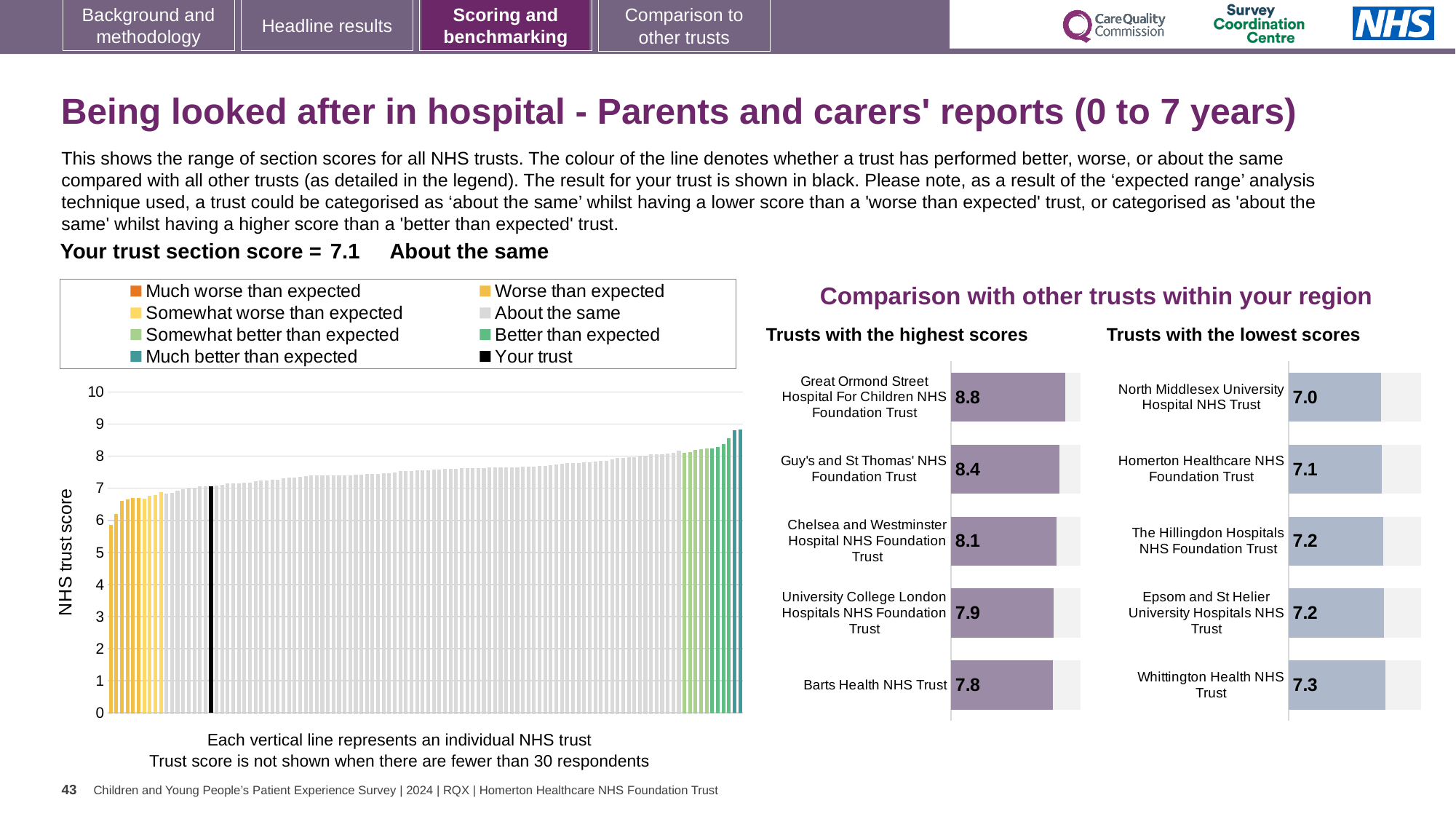
In the 'Trusts with the lowest scores' chart, what is the score for North Middlesex University Hospital NHS Trust? 7.0 In the 'Trusts with the lowest scores' chart, what is the score for Whittington Health NHS Trust? 7.3 In the 'Trusts with the highest scores' chart, what is the score for Great Ormond Street Hospital For Children NHS Foundation Trust? 8.8 In the 'Trusts with the highest scores' chart, what is the score for Barts Health NHS Trust? 7.8 What kind of chart is the main 'NHS trust score' chart on the left? Bar chart In the main 'NHS trust score' chart on the left, what is the section score for your trust? 7.1 How many entries does the legend of the main 'NHS trust score' chart list? 8 In the 'Trusts with the highest scores' chart, what is the difference between the scores of Great Ormond Street Hospital For Children NHS Foundation Trust and Guy's and St Thomas' NHS Foundation Trust? 0.4 In the 'Trusts with the lowest scores' chart, which has the higher score: Homerton Healthcare NHS Foundation Trust or Whittington Health NHS Trust? Whittington Health NHS Trust In the 'Trusts with the lowest scores' chart, which trust has the lowest score? North Middlesex University Hospital NHS Trust In the 'Trusts with the highest scores' chart, which trust has the highest score? Great Ormond Street Hospital For Children NHS Foundation Trust How many trusts are shown in the 'Trusts with the highest scores' chart? 5